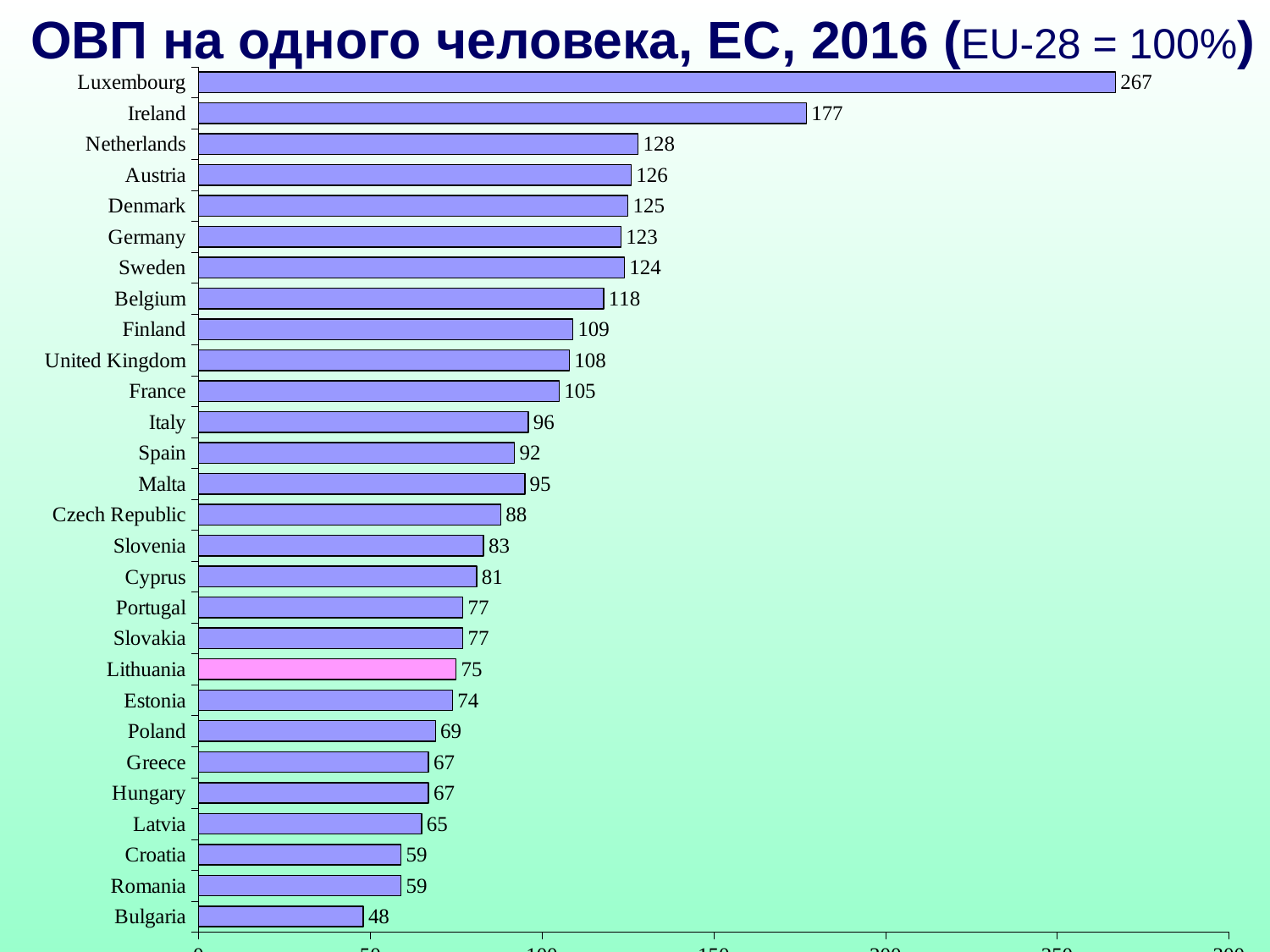
How many countries are shown in the chart? 28 Which country's bar is highlighted in a different colour (pink) from the others? Lithuania What is the difference between the values for Luxembourg and Ireland? 90 What is the value for Luxembourg? 267 What is the difference between the values for Lithuania and Bulgaria? 27 What kind of chart is shown on the slide? Bar chart Which country has the lowest value? Bulgaria Which country has the highest value? Luxembourg Which has a larger value, Netherlands or Finland? Netherlands What is the value for Lithuania? 75 Which has a larger value, Poland or Latvia? Poland What is the value for Germany? 123